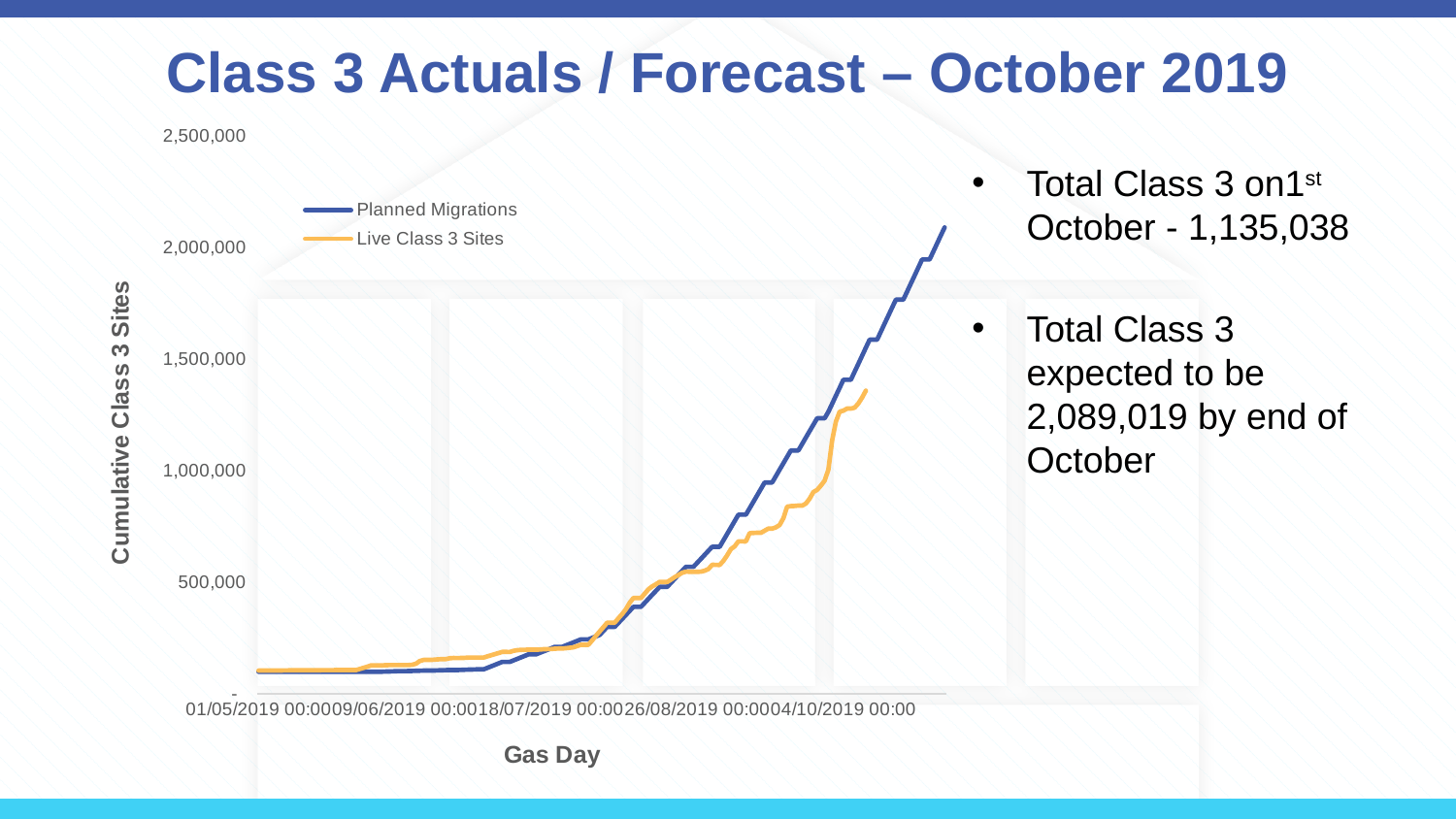
What is the highest value shown on the vertical axis of the chart? 2,500,000 At the right-hand end of the chart, which series is higher: Planned Migrations or Live Class 3 Sites? Planned Migrations What is the title of the vertical axis of the chart? Cumulative Class 3 Sites Is the final value of the Planned Migrations series greater or less than 1,500,000? greater Do the values of the Live Class 3 Sites series rise or fall along the x axis? Rise What are the two series named in the chart legend? Planned Migrations and Live Class 3 Sites What type of chart is shown on the slide? Line chart How many date labels are shown on the x axis of the chart? 5 Is the final value of the Live Class 3 Sites series greater or less than 1,000,000? greater Is the final value of the Live Class 3 Sites series greater or less than 1,500,000? less How many series does the chart legend list? 2 Do the values of the Planned Migrations series rise or fall along the x axis? Rise